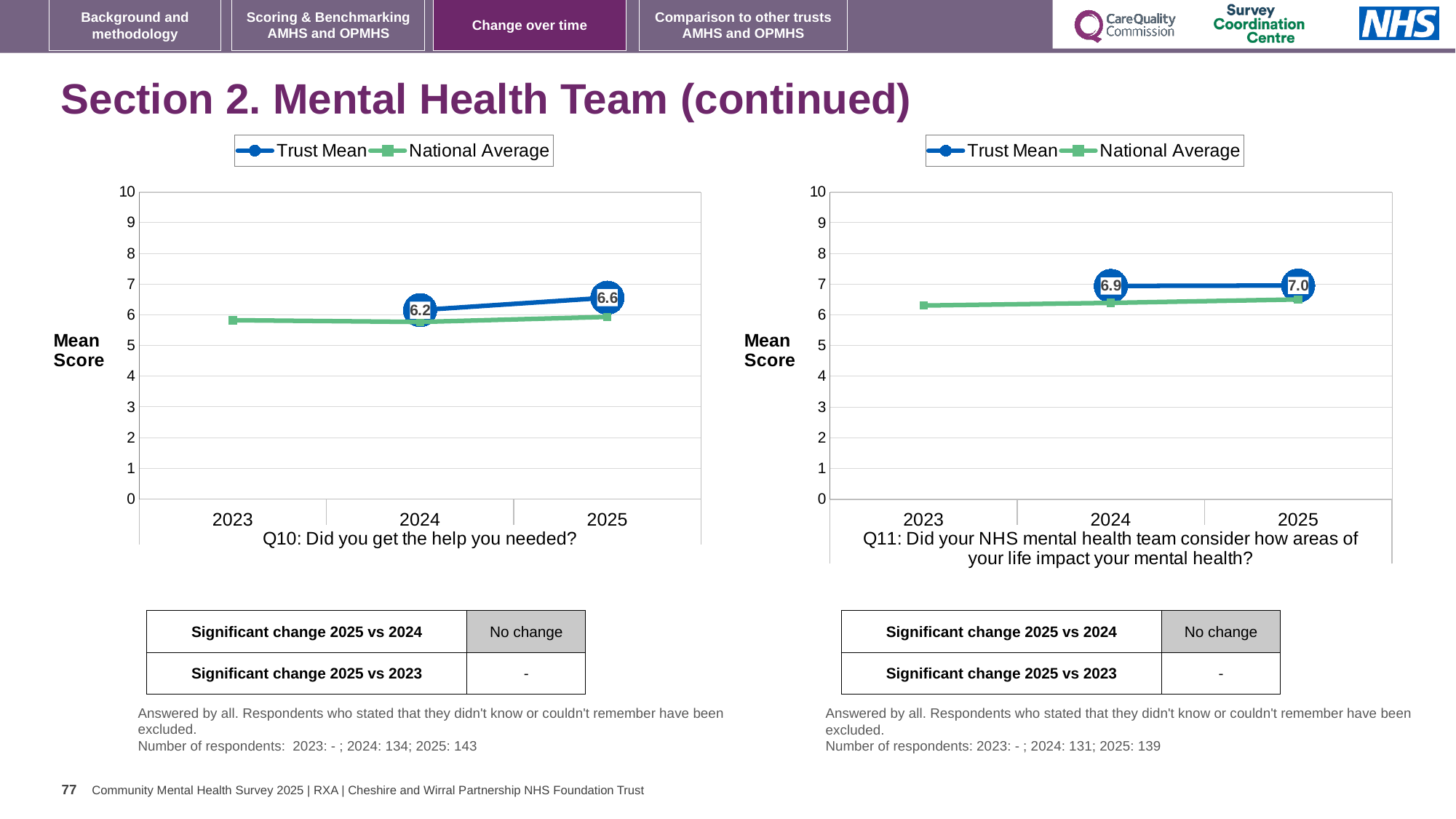
In the right chart (Q11), is the National Average for 2023 greater or less than 6? greater What type of chart is used for Q11 on the right of the slide? Line chart In the left chart (Q10), what is the Trust Mean score for 2024? 6.2 In the left chart (Q10), is the National Average for 2023 greater or less than 7? less How many years are shown on the x axis of the right chart (Q11)? 3 In the left chart (Q10: Did you get the help you needed?), what is the Trust Mean score for 2025? 6.6 In the left chart (Q10), by how much did the Trust Mean change from 2024 to 2025? 0.4 In the right chart (Q11), what is the Trust Mean score for 2024? 6.9 In the right chart (Q11), what is the Trust Mean score for 2025? 7.0 In the right chart (Q11), what is the difference between the Trust Mean for 2025 and 2024? 0.1 How many series does the legend of the left chart (Q10) list? 2 In the left chart (Q10), is the Trust Mean for 2025 higher or lower than the National Average for 2025? higher